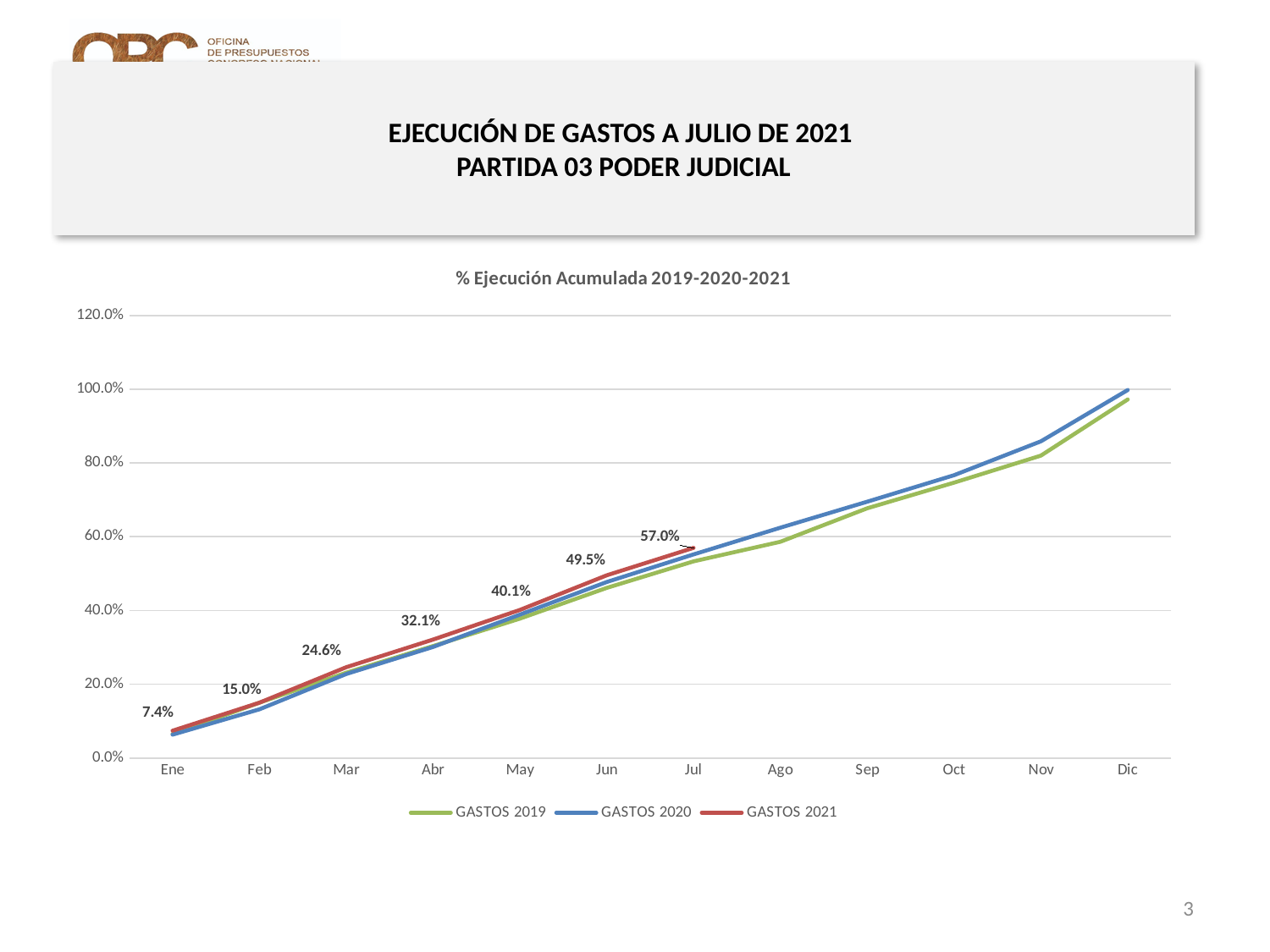
Which month has the highest value for GASTOS 2021? Jul What is the value of GASTOS 2021 in Ene? 7.4% How many series does the legend list? 3 Do the values of GASTOS 2020 rise or fall from Ene to Dic? Rise What is the title of the chart? % Ejecución Acumulada 2019-2020-2021 What kind of chart is shown on the slide? Line chart Is the value for GASTOS 2020 in Dic greater or less than 80.0%? greater What is the value of GASTOS 2021 in Jul? 57.0% How many months are shown on the x axis? 12 By how much did GASTOS 2021 increase from Jun to Jul? 7.5% What is the value of GASTOS 2021 in May? 40.1% What is the value of GASTOS 2021 in Mar? 24.6%